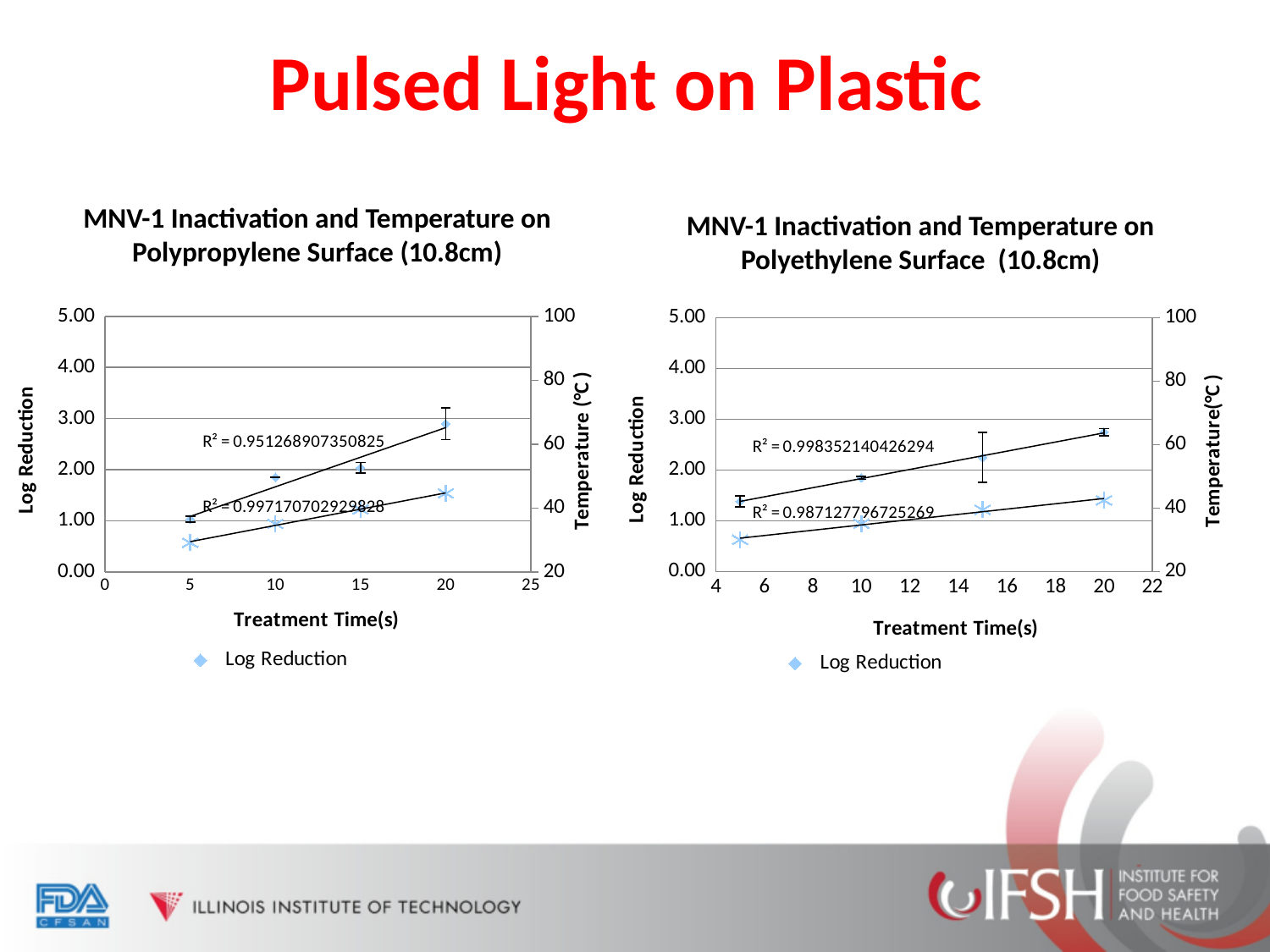
In the Polypropylene Surface chart, is the Log Reduction at 5 s greater or less than 2.00? less In the Polypropylene Surface chart, how many treatment time points are plotted for Log Reduction? 4 In the Polypropylene Surface chart, is the Log Reduction at 20 s greater or less than 2.00? greater What kind of chart is the 'MNV-1 Inactivation and Temperature on Polypropylene Surface (10.8cm)' chart? Scatter chart In the Polypropylene Surface chart, what is the R² value printed for the upper (Log Reduction) trendline? 0.951268907350825 In the Polyethylene Surface chart, what is the R² value printed for the upper (Log Reduction) trendline? 0.998352140426294 How many entries does the legend of the Polyethylene Surface chart list? 1 In the Polyethylene Surface chart, which has the larger Log Reduction: 5 s or 20 s? 20 s What is the x-axis title of the Polypropylene Surface chart? Treatment Time(s) In the Polypropylene Surface chart, does Log Reduction rise or fall as treatment time increases? Rises In the Polyethylene Surface chart, what is the R² value printed for the lower (temperature) trendline? 0.987127796725269 In the Polyethylene Surface chart, at which treatment time is Log Reduction highest? 20 s